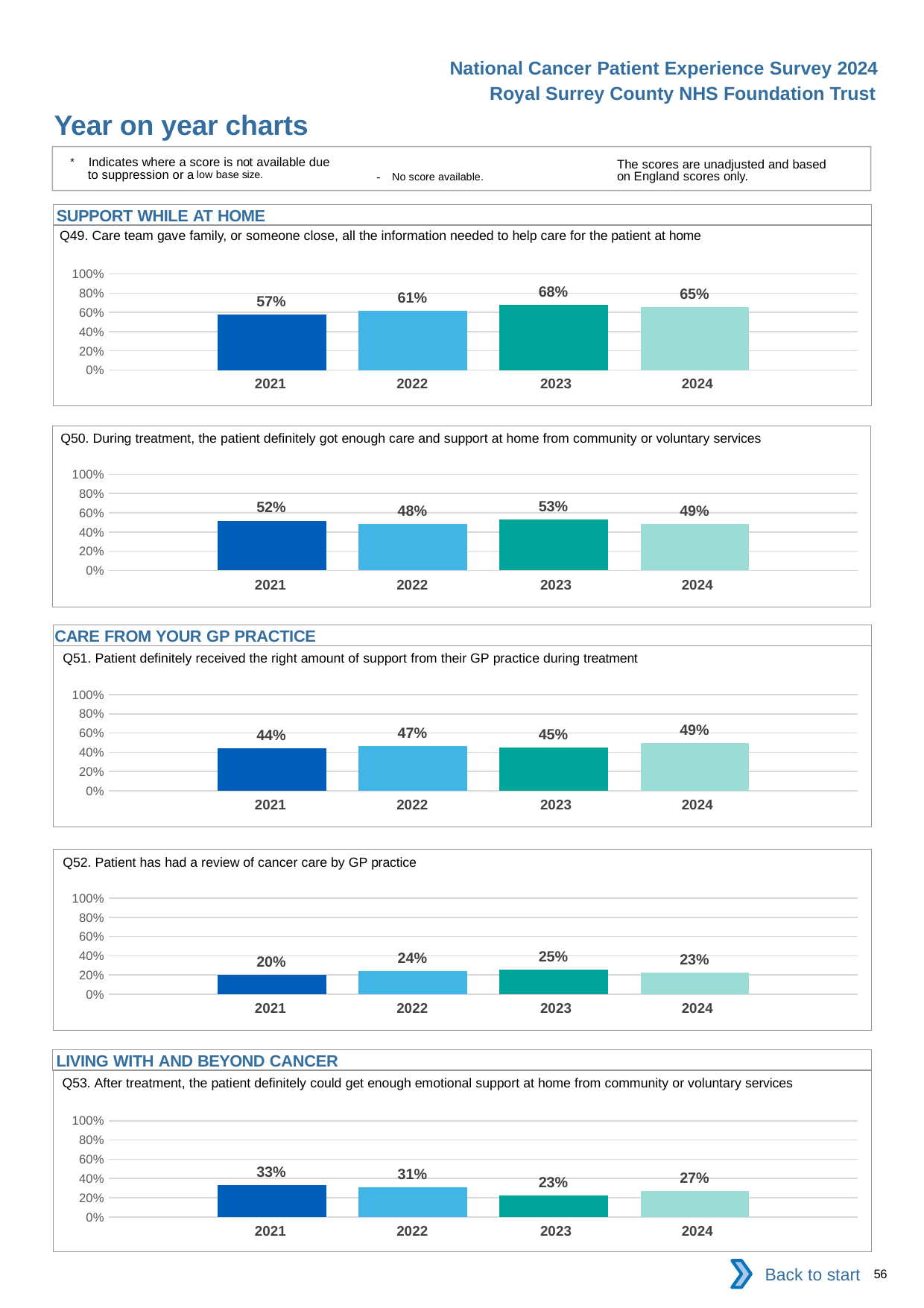
In the Q53 chart, which year has the lowest value? 2023 In the Q49 chart, which year has the lowest value? 2021 How many years are shown in the Q49 chart? 4 In the Q53 chart, what is the difference between the 2021 and 2024 values? 6% In the Q51 chart, which is larger, the value for 2022 or the value for 2023? 2022 In the Q50 chart, what is the difference between the 2023 and 2022 values? 5% In the Q50 chart, which year has the highest value? 2023 In the Q52 chart, is the value for 2023 greater or less than 40%? less In the Q51 chart, what is the value for 2024? 49% In the Q49 chart, what is the value for 2023? 68% What kind of chart is the Q52 chart? bar chart In the Q52 chart, what is the value for 2021? 20%